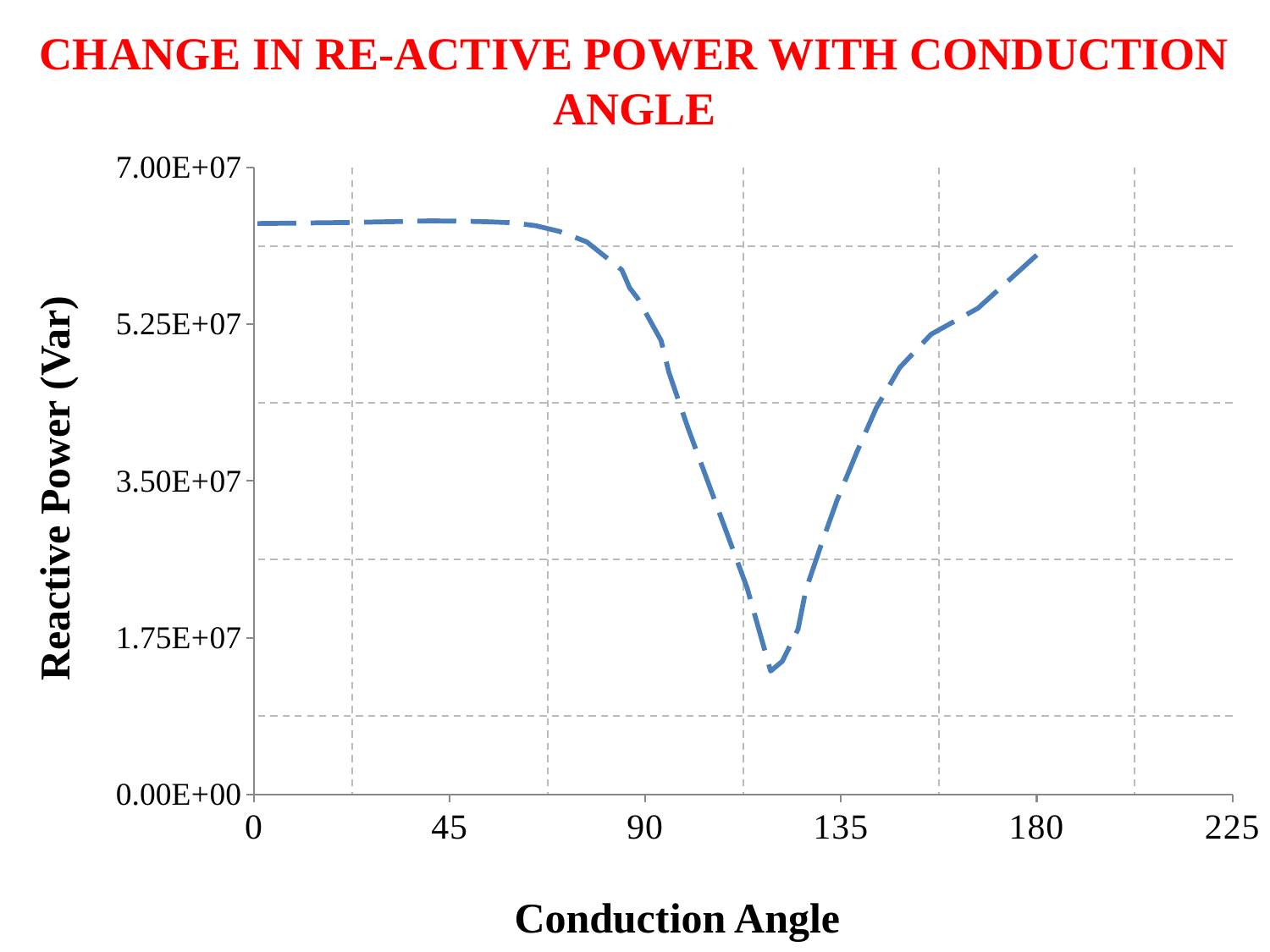
Is the reactive power at a conduction angle of 0 greater or less than 5.25E+07? greater What is the highest value shown on the vertical axis? 7.00E+07 Does the reactive power rise or fall as the conduction angle increases from 90 to about 120? fall What is the title of the chart? CHANGE IN RE-ACTIVE POWER WITH CONDUCTION ANGLE Is the lowest reactive power on the curve greater or less than 1.75E+07? less Does the reactive power rise or fall as the conduction angle increases from 135 to 180? rise How many lines are plotted on the chart? 1 What is the label of the vertical axis? Reactive Power (Var) Is the reactive power at a conduction angle of 45 greater or less than 7.00E+07? less What kind of chart is shown on the slide? line chart